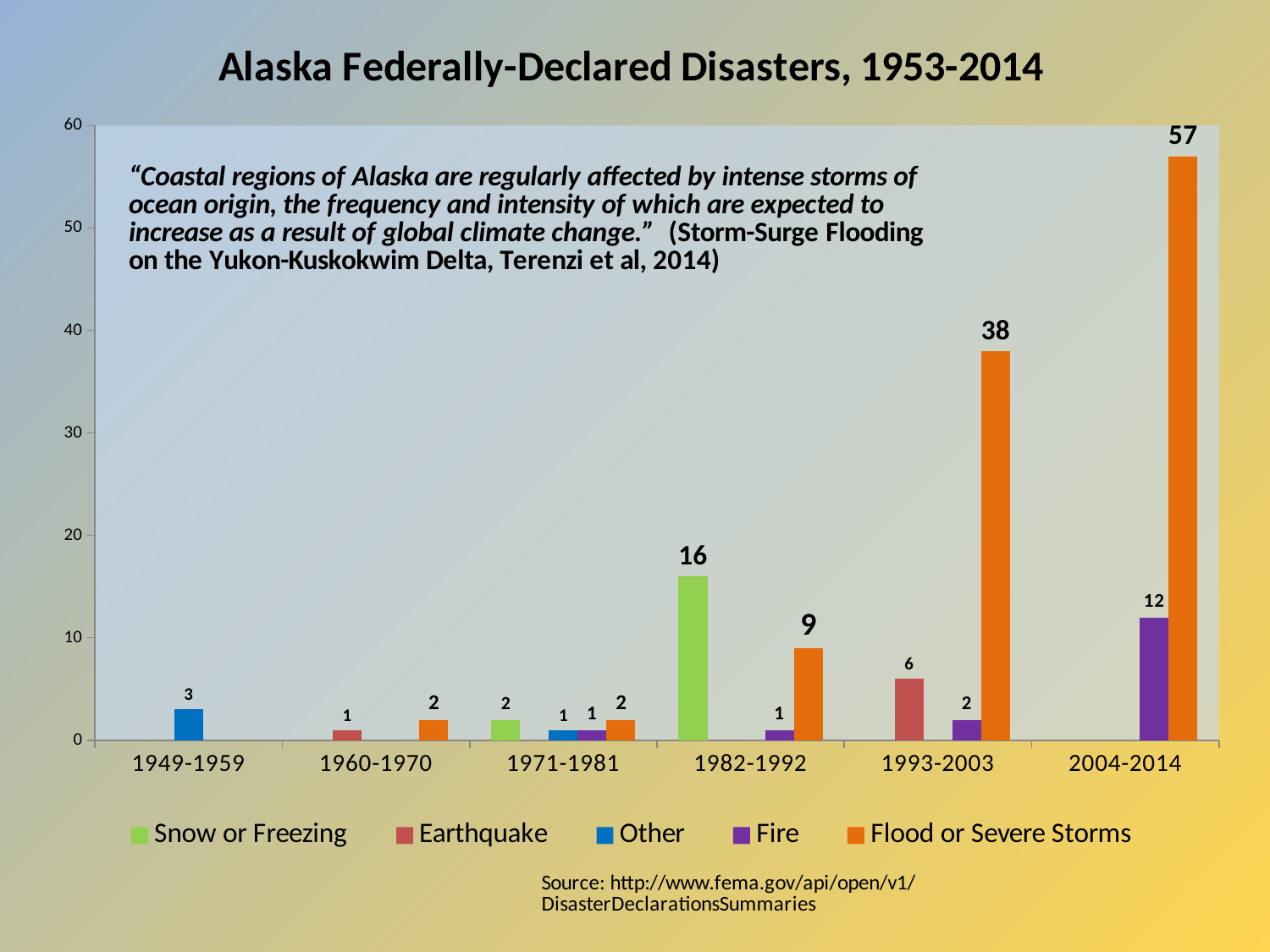
Which period has the highest value for Flood or Severe Storms? 2004-2014 How many time periods are shown on the x axis? 6 What kind of chart is shown on the slide? Bar chart Does the value for Flood or Severe Storms rise or fall from 1982-1992 to 2004-2014? Rise Is the value for Flood or Severe Storms in 1993-2003 greater or less than 30? greater What is the value for Flood or Severe Storms in 2004-2014? 57 What is the value for Snow or Freezing in 1982-1992? 16 How many series does the legend list? 5 What is the value for Earthquake in 1993-2003? 6 What is the value for Fire in 2004-2014? 12 What is the difference between Flood or Severe Storms in 2004-2014 and in 1993-2003? 19 Which is larger in 1982-1992: Snow or Freezing or Flood or Severe Storms? Snow or Freezing